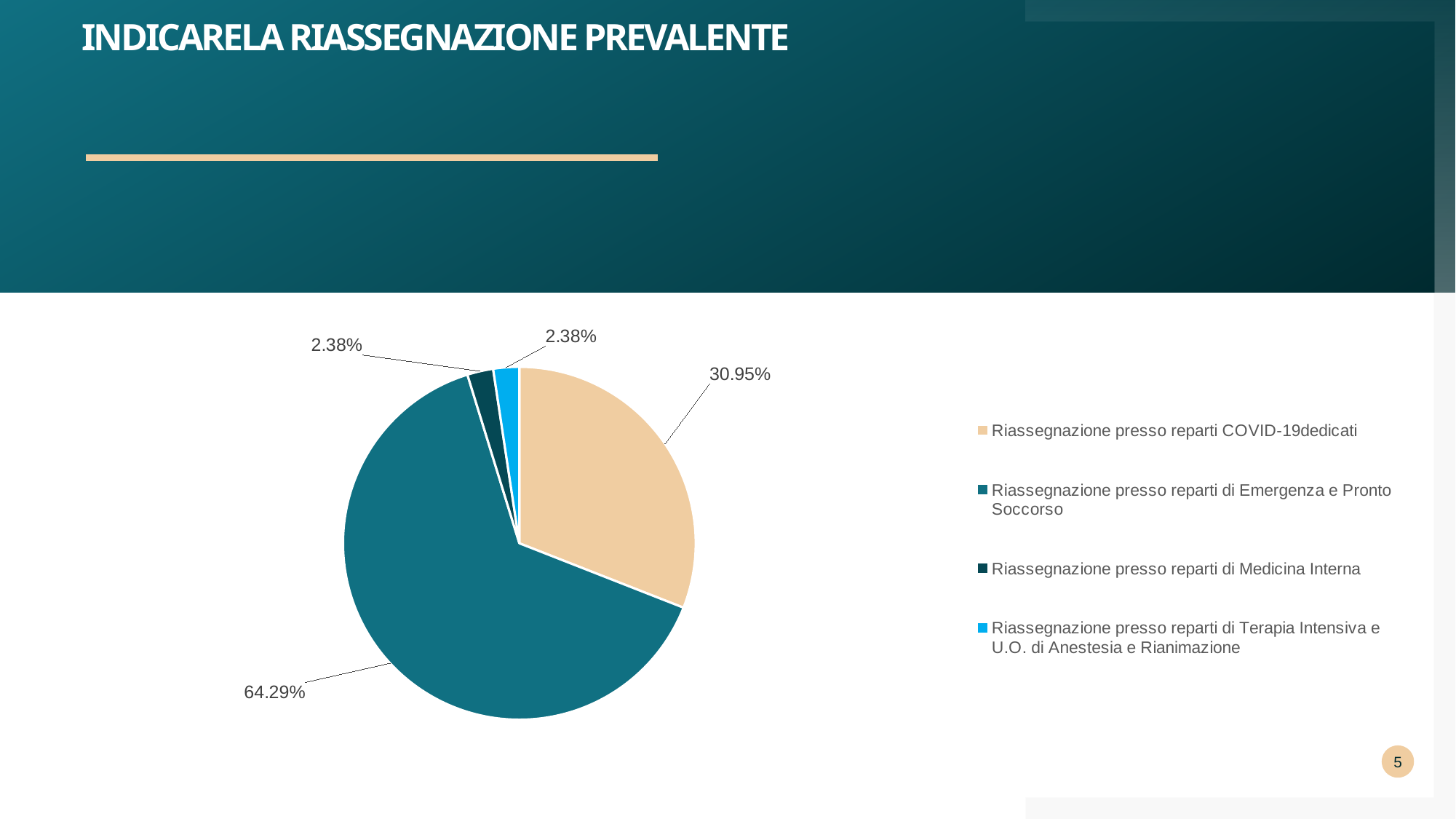
What share of the pie is labelled for Riassegnazione presso reparti di Terapia Intensiva e U.O. di Anestesia e Rianimazione? 2.38% What kind of chart is shown on the slide? Pie chart Which category has the largest slice of the pie? Riassegnazione presso reparti di Emergenza e Pronto Soccorso What share of the pie is labelled for Riassegnazione presso reparti di Emergenza e Pronto Soccorso? 64.29% Which is larger: the slice for reparti COVID-19 dedicati or the slice for reparti di Medicina Interna? Riassegnazione presso reparti COVID-19 dedicati What is the difference in percentage points between the Emergenza e Pronto Soccorso slice and the COVID-19 dedicati slice? 33.34 How many slices does the pie chart have? 4 What share of the pie is labelled for Riassegnazione presso reparti di Medicina Interna? 2.38% How many entries does the legend list? 4 What colour is the slice for Riassegnazione presso reparti COVID-19 dedicati? Tan (beige) What is the title of the slide containing the pie chart? INDICARELA RIASSEGNAZIONE PREVALENTE What share of the pie is labelled for Riassegnazione presso reparti COVID-19 dedicati? 30.95%